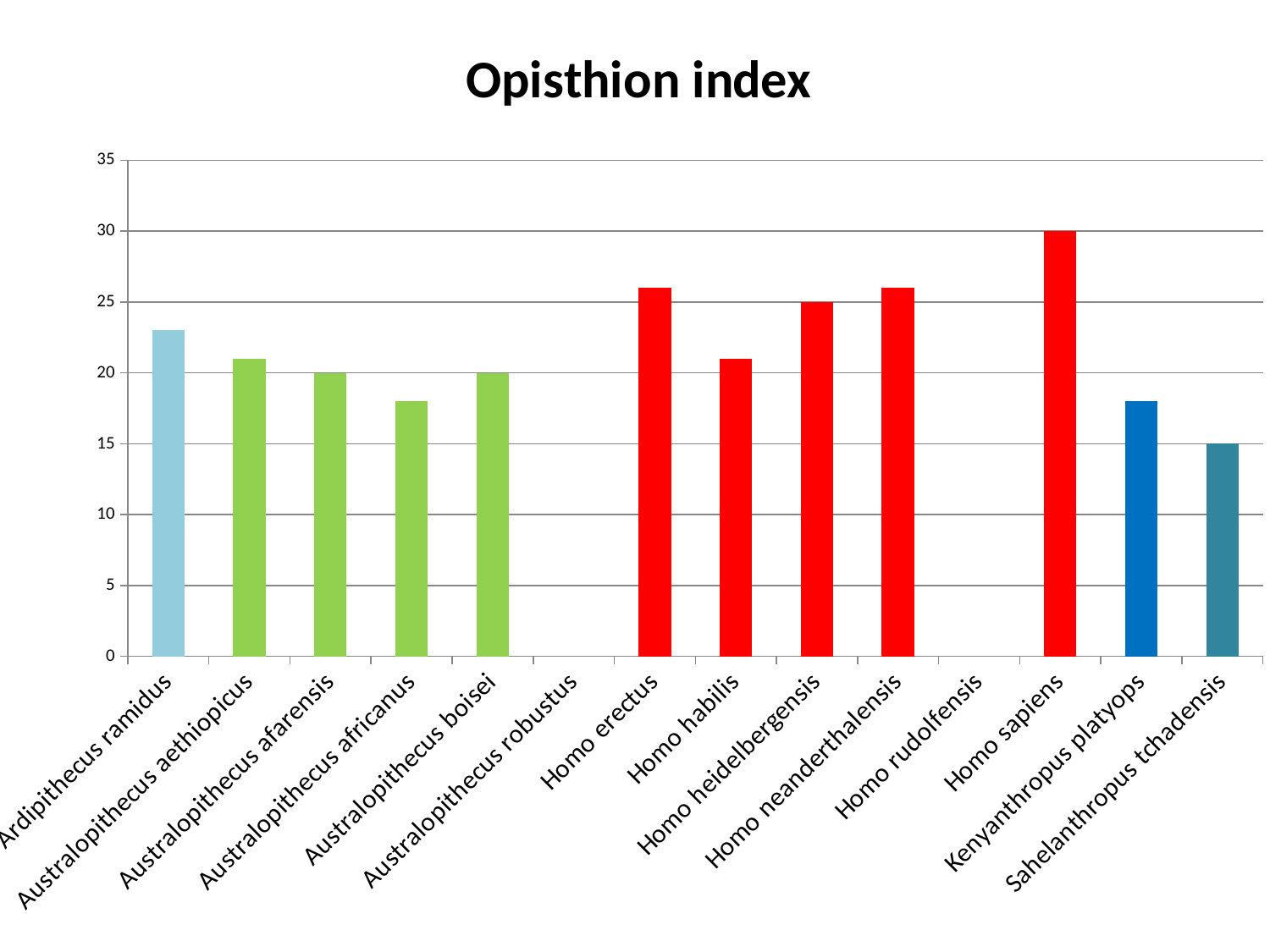
How many categories are listed along the x axis? 14 Which is larger, the value for Homo sapiens or the value for Homo erectus? Homo sapiens What type of chart is shown on the slide? bar chart What is the value for Australopithecus afarensis? 20 What is the value for Homo sapiens? 30 Is the value for Ardipithecus ramidus greater or less than 20? greater What is the value for Homo heidelbergensis? 25 What is the title of the chart? Opisthion index What is the difference between the values for Homo sapiens and Homo heidelbergensis? 5 Is the value for Kenyanthropus platyops greater or less than 20? less What is the value for Sahelanthropus tchadensis? 15 Which category has the highest value in the chart? Homo sapiens